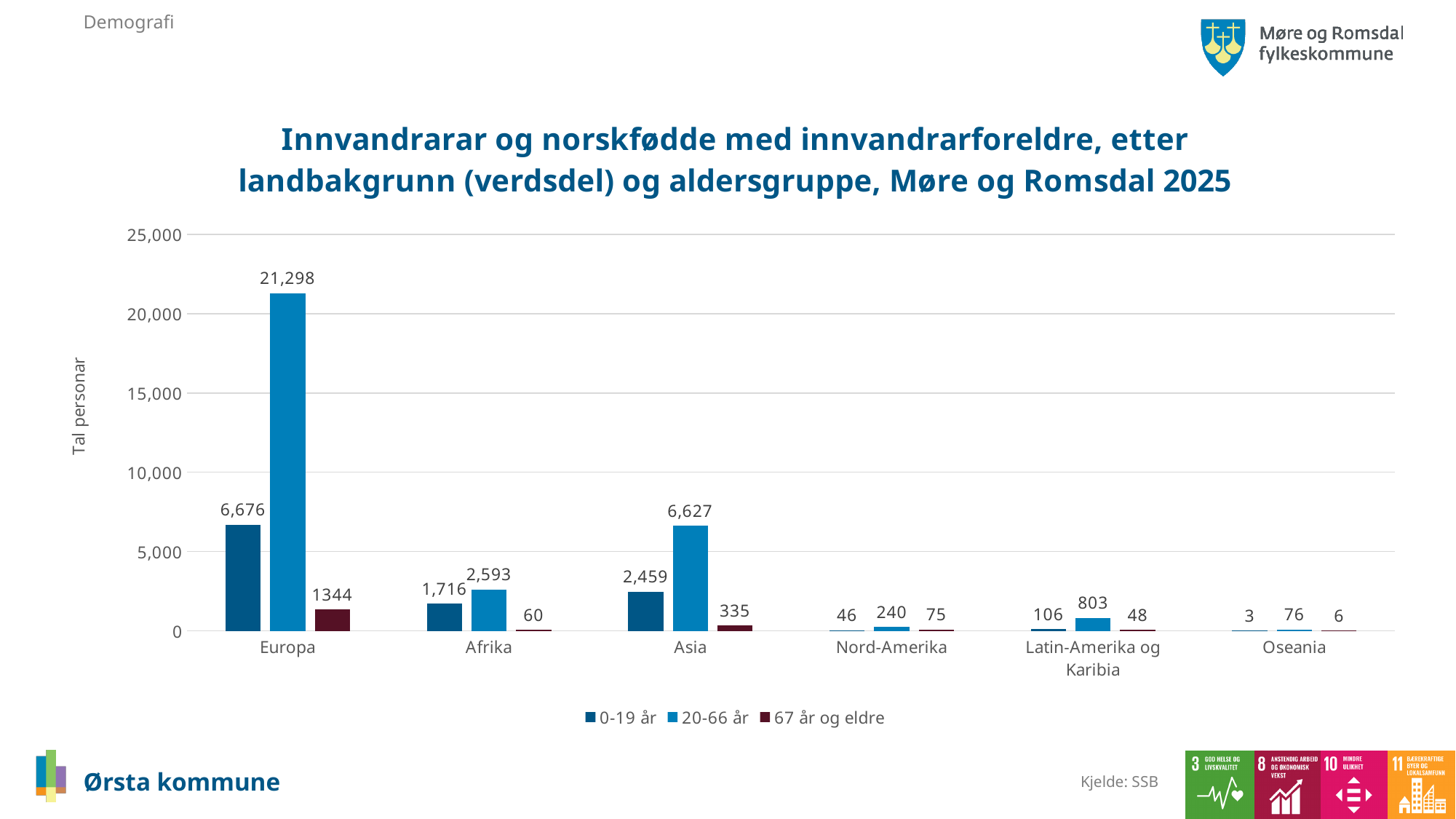
Which is larger: the 0-19 år value for Europa or the 20-66 år value for Asia? 0-19 år value for Europa What is the total of the three series for Nord-Amerika? 361 How many categories are shown on the x axis? 6 What kind of chart is shown on the slide? Bar chart What is the value for the 20-66 år series for Europa? 21,298 What is the value for the 20-66 år series for Latin-Amerika og Karibia? 803 Which category has the highest value in the 20-66 år series? Europa What is the value for the 0-19 år series for Asia? 2,459 What is the value for the 67 år og eldre series for Afrika? 60 How many series does the legend list? 3 Which category has the lowest value in the 0-19 år series? Oseania What is the difference between the 20-66 år values for Europa and Asia? 14,671